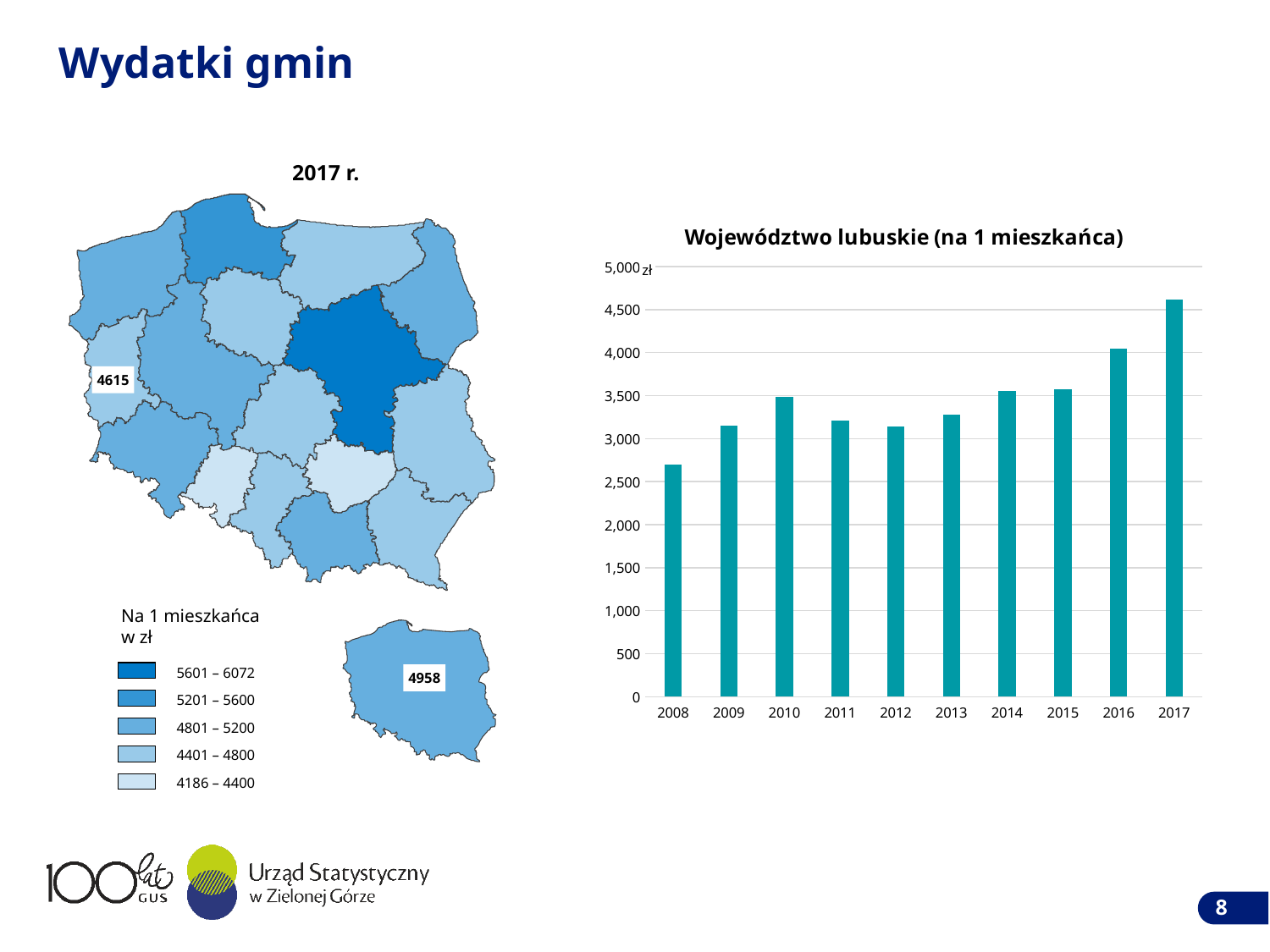
In the bar chart 'Województwo lubuskie (na 1 mieszkańca)', is the value for 2010 greater or less than 3,000? greater In the bar chart 'Województwo lubuskie (na 1 mieszkańca)', which year has the lowest value? 2008 On the map for 2017 r., what value is labelled on the highlighted western voivodeship? 4615 What kind of chart is the chart titled 'Województwo lubuskie (na 1 mieszkańca)'? bar chart In the bar chart 'Województwo lubuskie (na 1 mieszkańca)', is the value for 2013 greater or less than 3,500? less In the bar chart 'Województwo lubuskie (na 1 mieszkańca)', is the value for 2008 greater or less than 3,000? less In the bar chart 'Województwo lubuskie (na 1 mieszkańca)', which year has the highest value? 2017 In the bar chart 'Województwo lubuskie (na 1 mieszkańca)', do the values overall rise or fall from 2008 to 2017? rise How many years are shown on the x axis of the bar chart 'Województwo lubuskie (na 1 mieszkańca)'? 10 In the bar chart 'Województwo lubuskie (na 1 mieszkańca)', which is larger, the value for 2010 or the value for 2011? 2010 What value is labelled on the small inset map of Poland below the main map? 4958